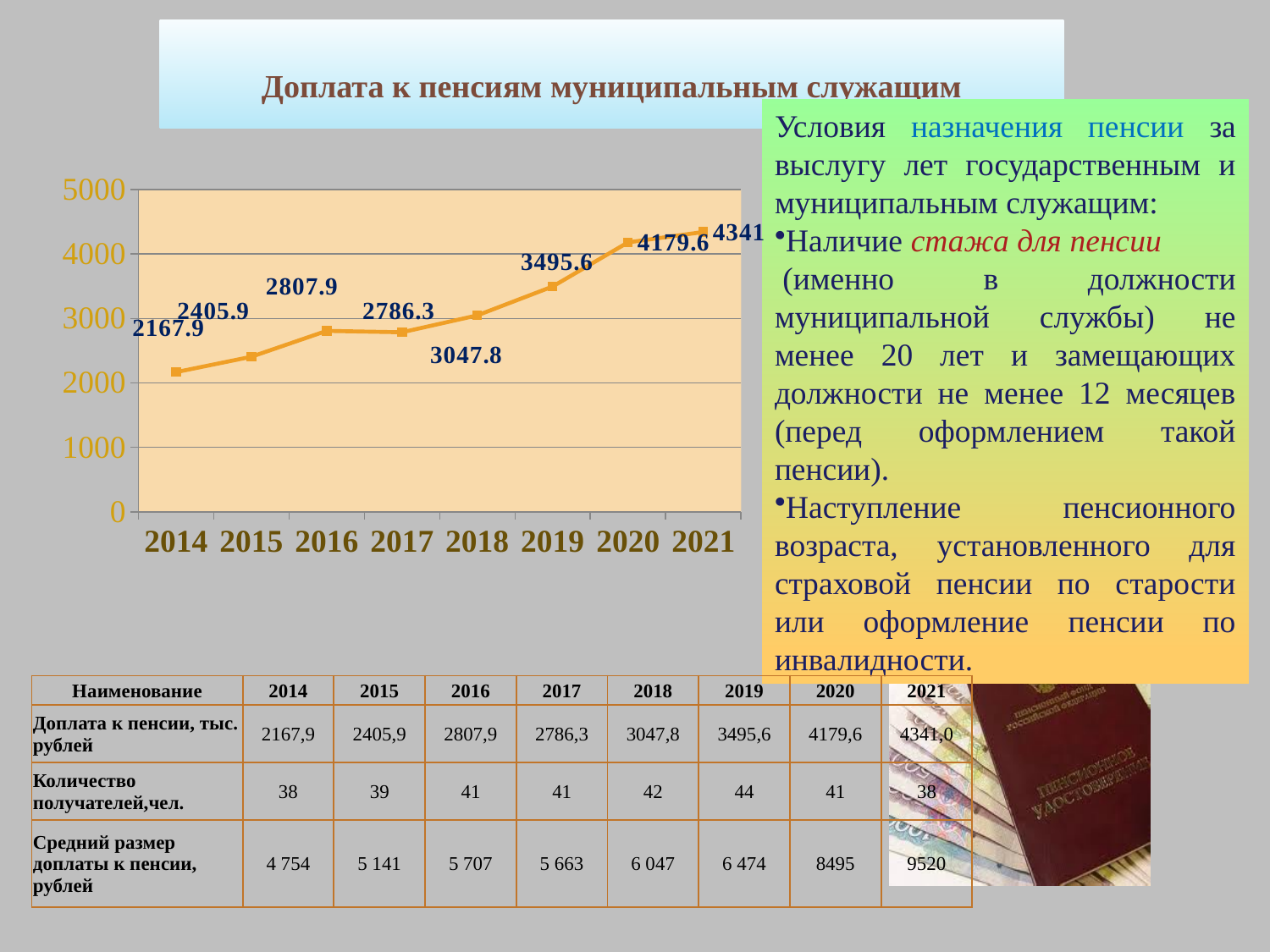
Which year has the lowest value on the chart? 2014 How many years are plotted on the x axis of the chart? 8 What type of chart is shown on the slide? line chart What is the value plotted for 2018? 3047.8 What is the value plotted for 2014? 2167.9 What is the difference between the values for 2020 and 2019? 684 Which year has the highest value on the chart? 2021 What is the difference between the values for 2016 and 2017? 21.6 Is the value for 2019 greater or less than 3000? greater Which is larger, the value for 2016 or the value for 2017? 2016 Do the values generally rise or fall from 2014 to 2021? rise What is the value plotted for 2020? 4179.6